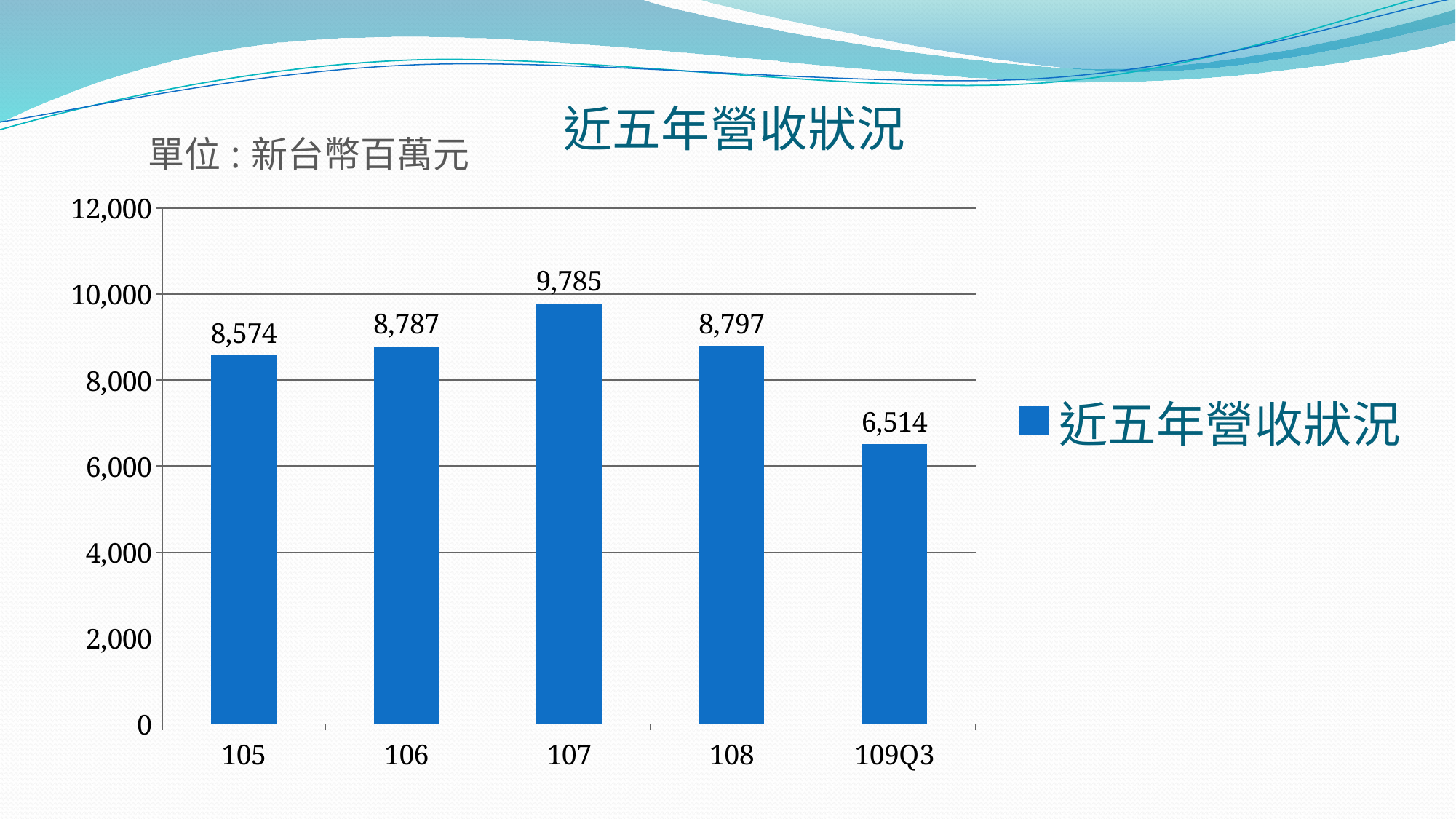
What is the value for 105? 8,574 What kind of chart is shown on the slide? bar chart What is the value for 109Q3? 6,514 How many categories are shown on the x axis? 5 Which category has the lowest value? 109Q3 What is the title of the chart? 近五年營收狀況 What is the difference between the values for 107 and 108? 988 Which category has the highest value? 107 What is the difference between the values for 106 and 105? 213 What is the value for 107? 9,785 Which is larger, the value for 107 or the value for 109Q3? 107 Is the value for 109Q3 greater or less than 8,000? less